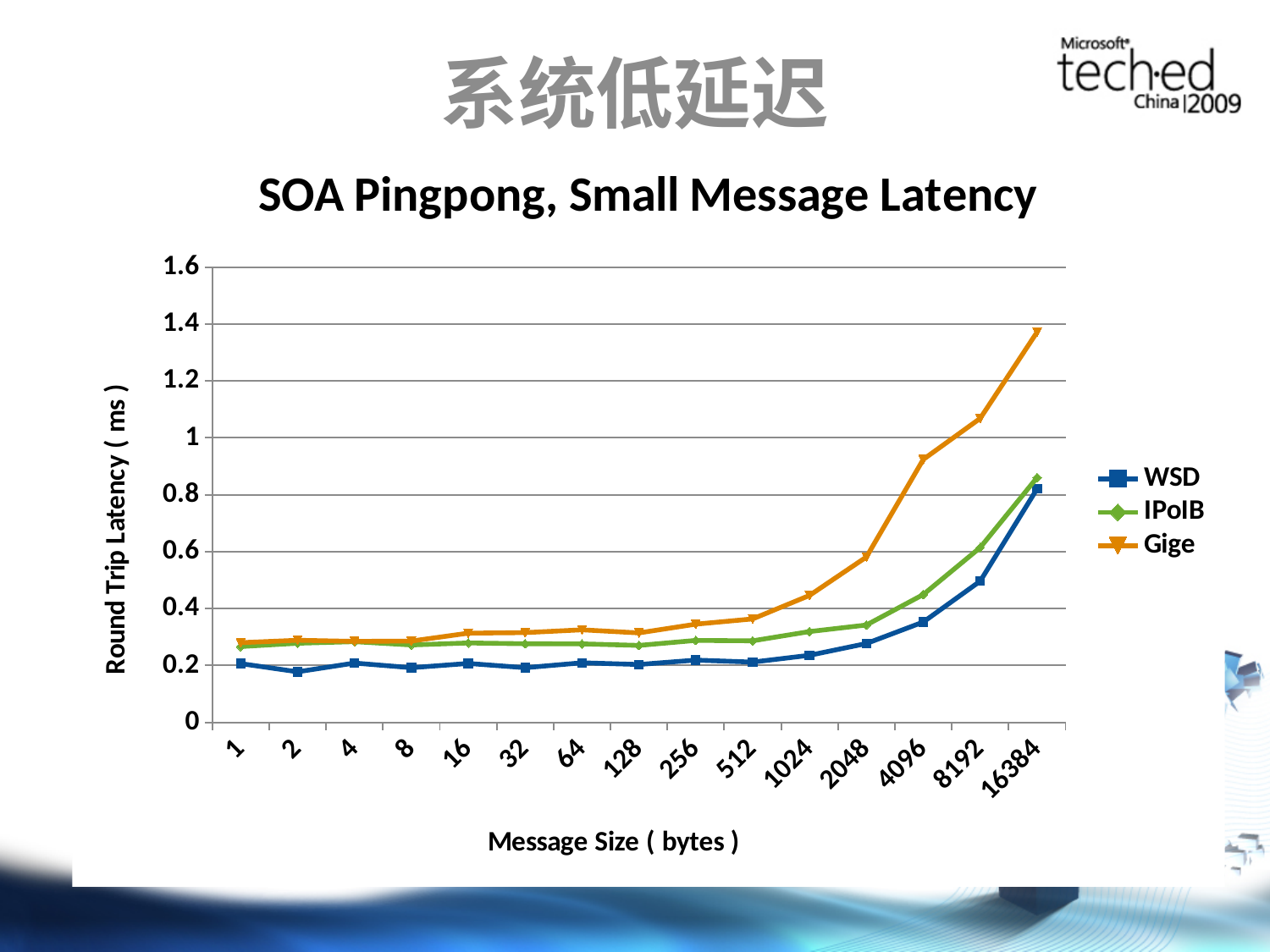
What is the title of the chart? SOA Pingpong, Small Message Latency What kind of chart is shown on the slide? line chart Is the Gige value at message size 16384 greater or less than 1.2? greater Which series has the highest latency at message size 16384? Gige Is the IPoIB value at message size 8192 greater or less than 0.8? less How many series does the legend list? 3 Which series has the lowest latency at message size 1024? WSD At message size 4096, which series has the larger latency, Gige or WSD? Gige Is the WSD value at message size 16384 greater or less than 1? less What is the label of the y axis? Round Trip Latency ( ms ) How many message sizes are plotted along the x axis? 15